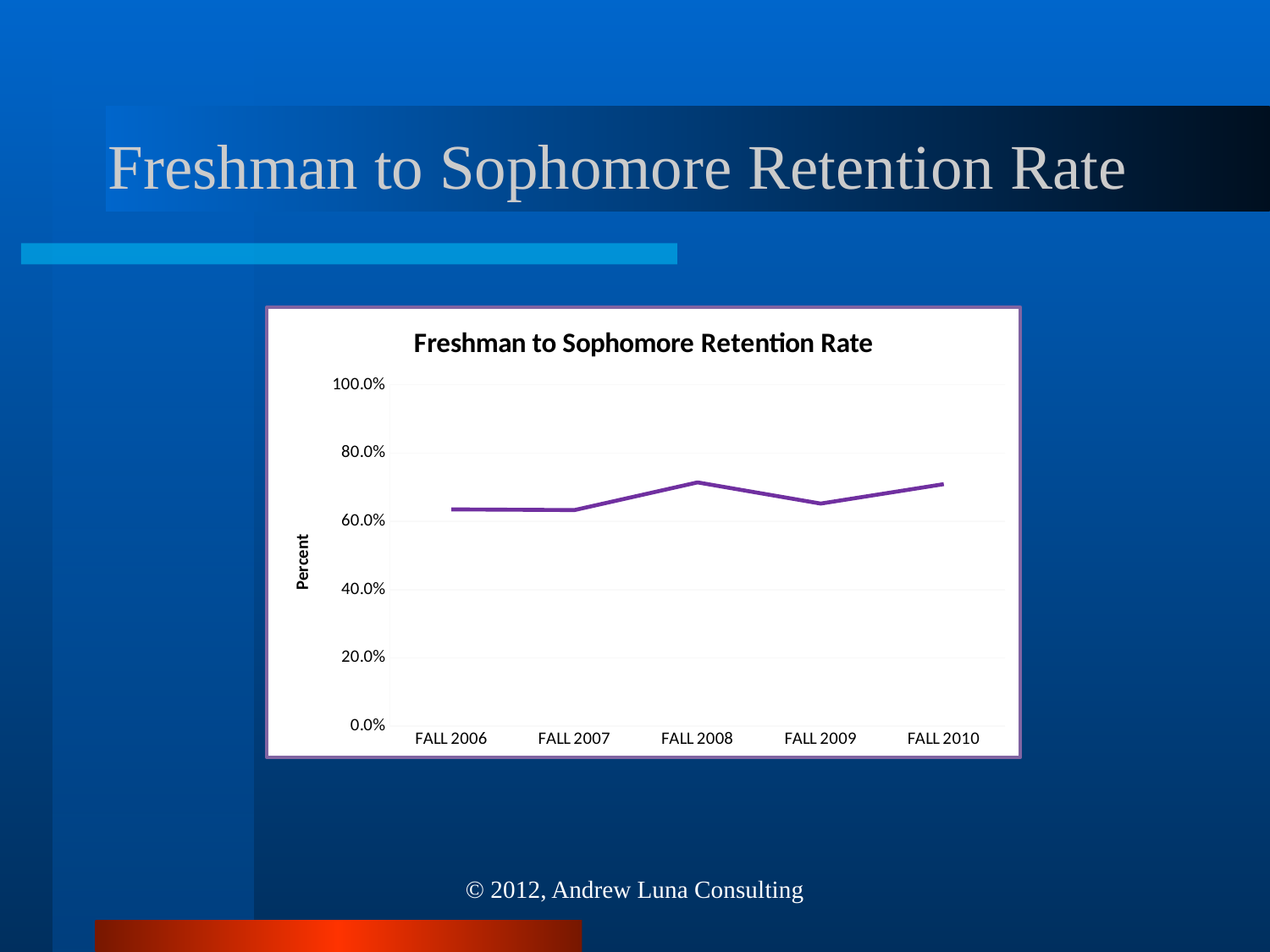
Does the retention rate rise or fall from FALL 2007 to FALL 2008? rise What is the label on the vertical axis of the chart? Percent Which has the higher retention rate, FALL 2007 or FALL 2010? FALL 2010 Is the retention rate for FALL 2008 greater or less than 60.0%? greater Is the retention rate for FALL 2010 greater or less than 80.0%? less What kind of chart is shown on the slide? line chart How many data points are plotted on the chart? 5 Which has the higher retention rate, FALL 2008 or FALL 2009? FALL 2008 What is the title of the chart? Freshman to Sophomore Retention Rate Does the retention rate rise or fall from FALL 2008 to FALL 2009? fall Is the retention rate for FALL 2009 greater or less than 60.0%? greater